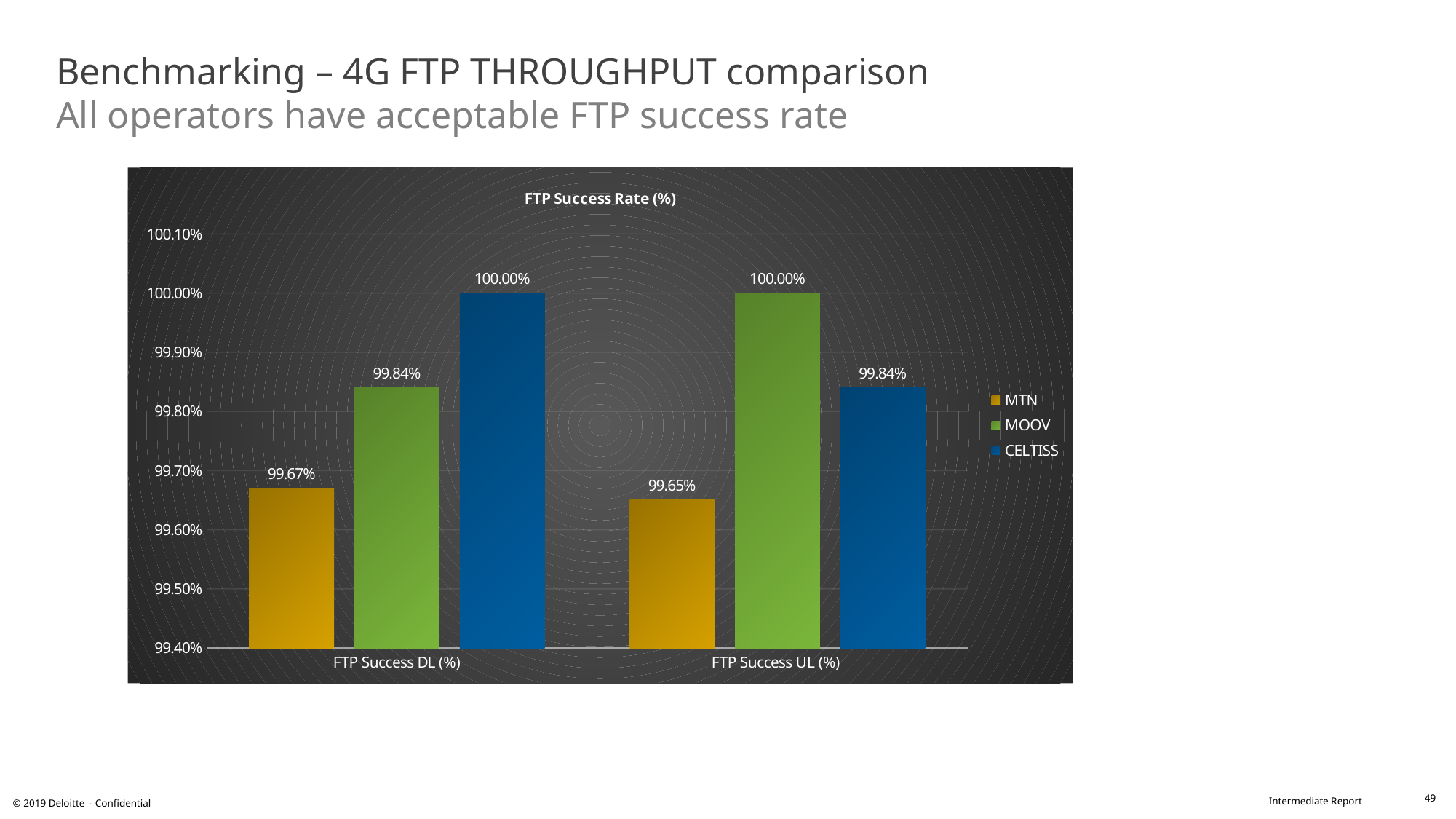
What is the FTP Success UL (%) value for MTN? 99.65% What is the FTP Success UL (%) value for CELTISS? 99.84% Which operator has the lowest FTP Success UL (%)? MTN Is the FTP Success DL (%) value for MTN greater or less than 99.70%? less How many series does the legend list? 3 What kind of chart is shown on the slide? Bar chart Which operator has the highest FTP Success DL (%)? CELTISS What is the title of the chart? FTP Success Rate (%) What is the FTP Success DL (%) value for MOOV? 99.84% What is the difference between CELTISS and MTN for FTP Success DL (%)? 0.33% Which is larger: MOOV's FTP Success UL (%) or CELTISS's FTP Success UL (%)? MOOV What is the FTP Success DL (%) value for MTN? 99.67%